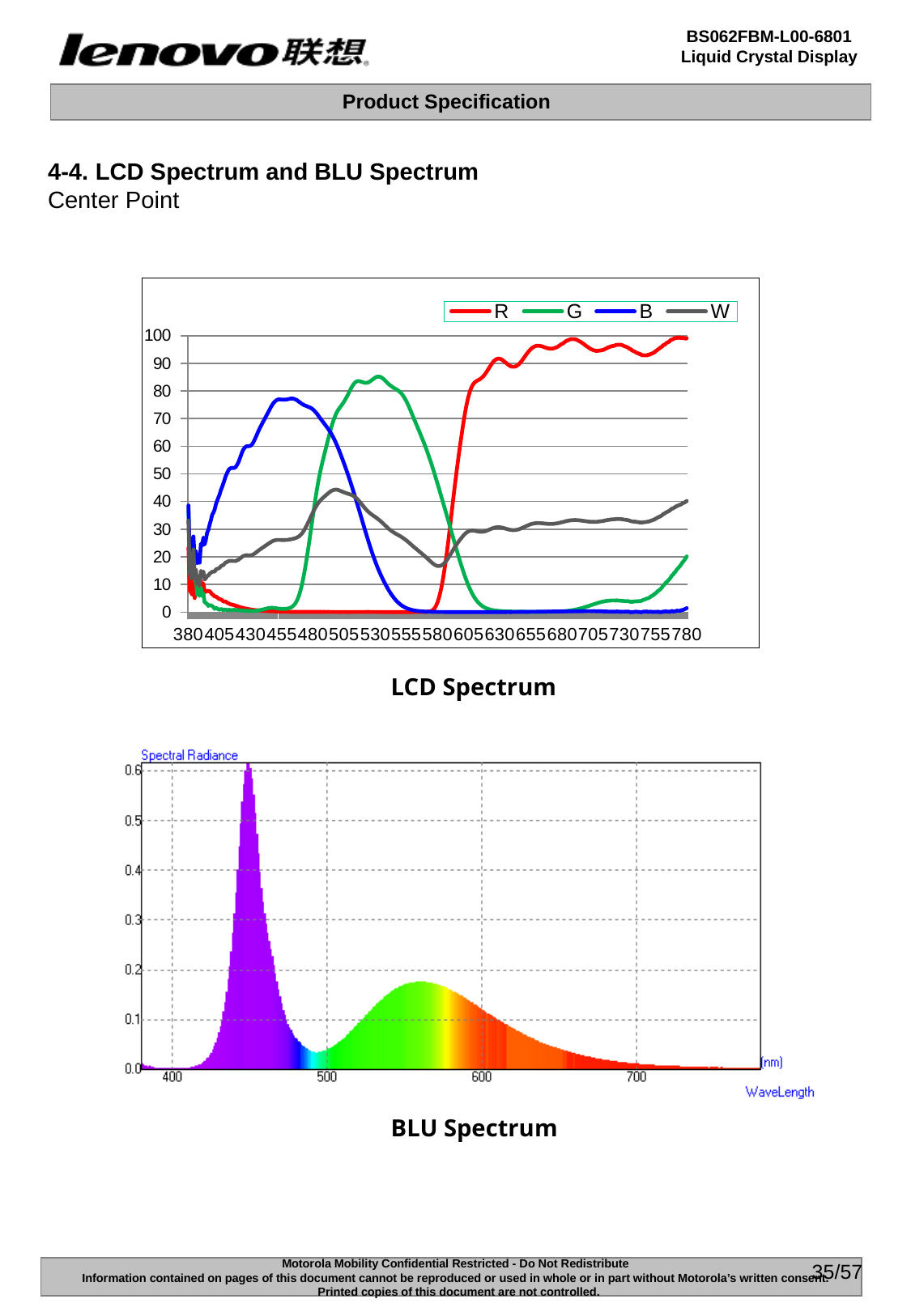
On the BLU Spectrum chart, is the highest peak greater or less than 0.5? greater On the LCD Spectrum chart, is the peak value of B greater or less than 70? greater On the BLU Spectrum chart, which peak is higher, the one near 450 nm or the one near 560 nm? the one near 450 nm What kind of chart is the LCD Spectrum chart? line chart On the LCD Spectrum chart, is the peak value of G greater or less than 80? greater On the LCD Spectrum chart, what are the legend entries? R, G, B, W On the LCD Spectrum chart, at 480 which series is higher, B or G? B On the LCD Spectrum chart, which series reaches the highest value? R On the LCD Spectrum chart, does the R series rise or fall between 580 and 605? rise On the LCD Spectrum chart, how many series does the legend list? 4 On the LCD Spectrum chart, at 530 which series is higher, G or B? G